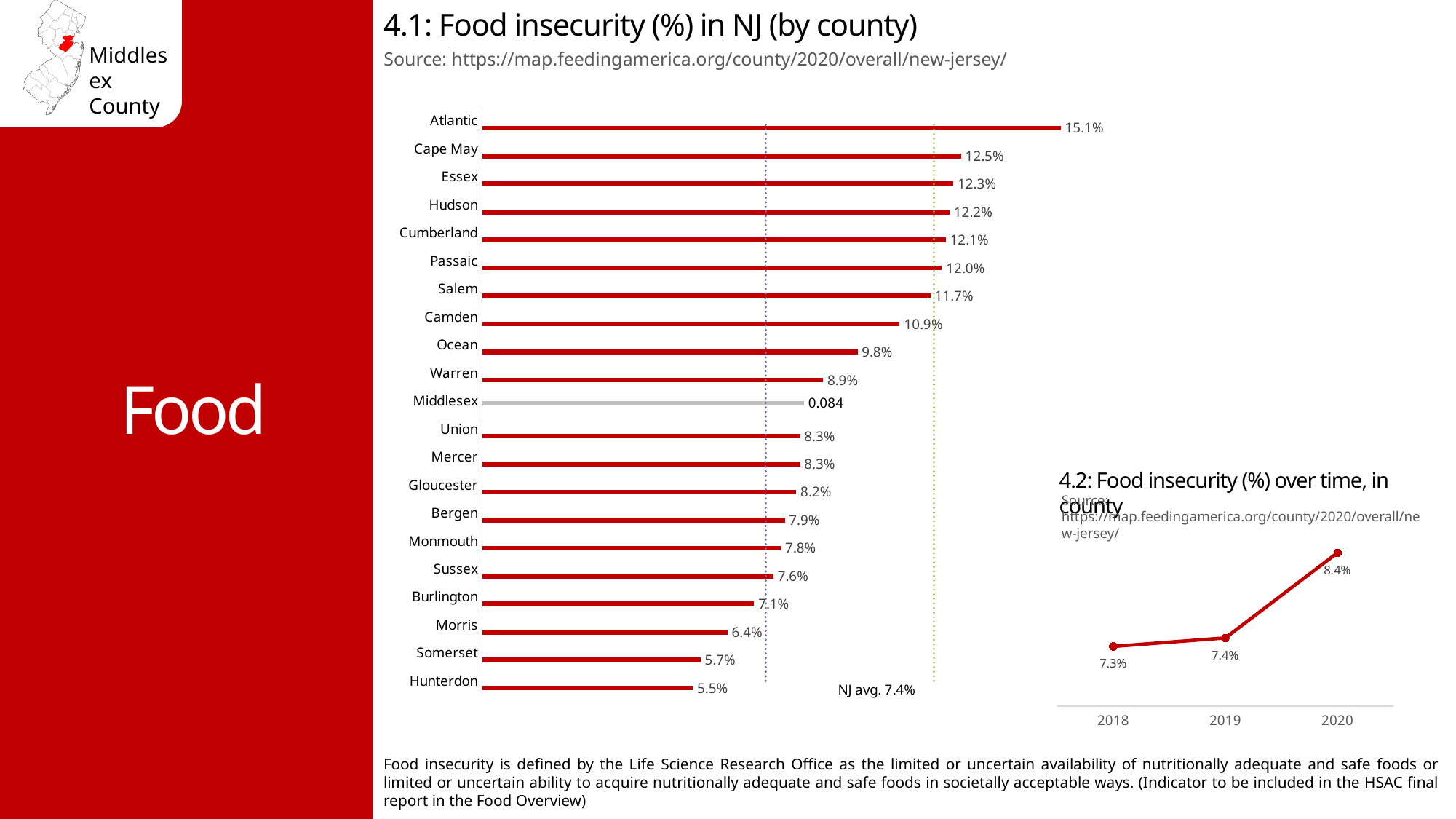
In chart 4.1 (Food insecurity by county), what NJ average value is printed on the chart? 7.4% In chart 4.2 (Food insecurity over time), what is the value for 2020? 8.4% In chart 4.2 (Food insecurity over time), do the values rise or fall from 2018 to 2020? Rise In chart 4.1 (Food insecurity by county), what label is printed next to the Middlesex bar? 0.084 How many counties are shown in chart 4.1 (Food insecurity by county)? 21 In chart 4.1 (Food insecurity by county), which county has the lowest value? Hunterdon In chart 4.1 (Food insecurity by county), what is the value for Atlantic? 15.1% In chart 4.1 (Food insecurity by county), what is the value for Camden? 10.9% What kind of chart is chart 4.1 (Food insecurity by county)? Bar chart In chart 4.1 (Food insecurity by county), which county has the highest value? Atlantic In chart 4.1 (Food insecurity by county), what is the difference between Cape May and Somerset? 6.8% In chart 4.1 (Food insecurity by county), which is larger, Ocean or Warren? Ocean